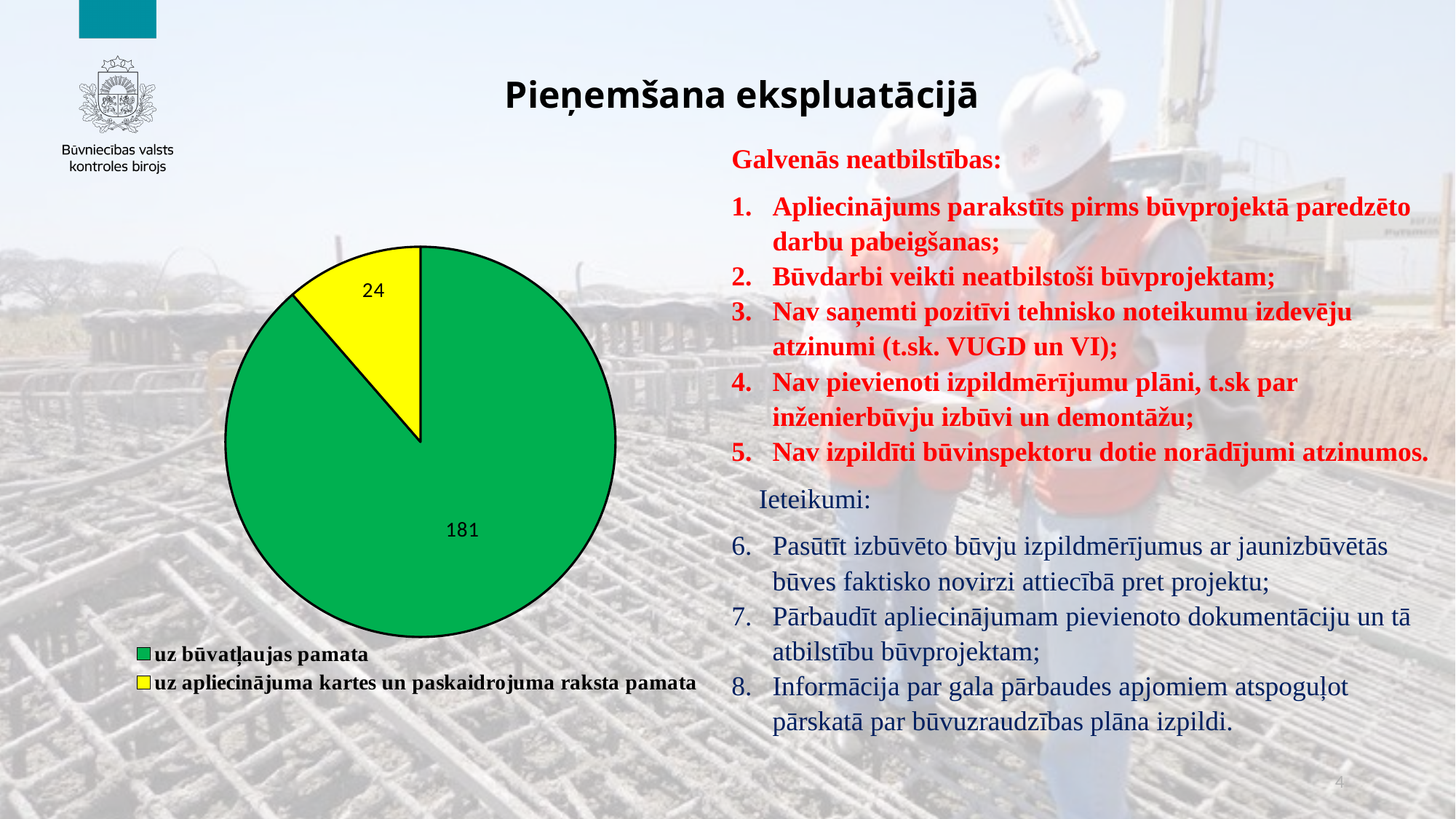
What is the value for "uz apliecinājuma kartes un paskaidrojuma raksta pamata" in the pie chart? 24 What is the value for "uz būvatļaujas pamata" in the pie chart? 181 What is the total of all slices in the pie chart? 205 Which category has the smallest slice in the pie chart? uz apliecinājuma kartes un paskaidrojuma raksta pamata What kind of chart is shown on the slide? pie chart How many slices does the pie chart have? 2 What is the difference between the values for "uz būvatļaujas pamata" and "uz apliecinājuma kartes un paskaidrojuma raksta pamata"? 157 What colour is the slice for "uz būvatļaujas pamata"? green What share of the pie does "uz apliecinājuma kartes un paskaidrojuma raksta pamata" represent? 11.7% What colour is the slice for "uz apliecinājuma kartes un paskaidrojuma raksta pamata"? yellow Which category has the largest slice in the pie chart? uz būvatļaujas pamata Which is larger: the value for "uz būvatļaujas pamata" or the value for "uz apliecinājuma kartes un paskaidrojuma raksta pamata"? uz būvatļaujas pamata